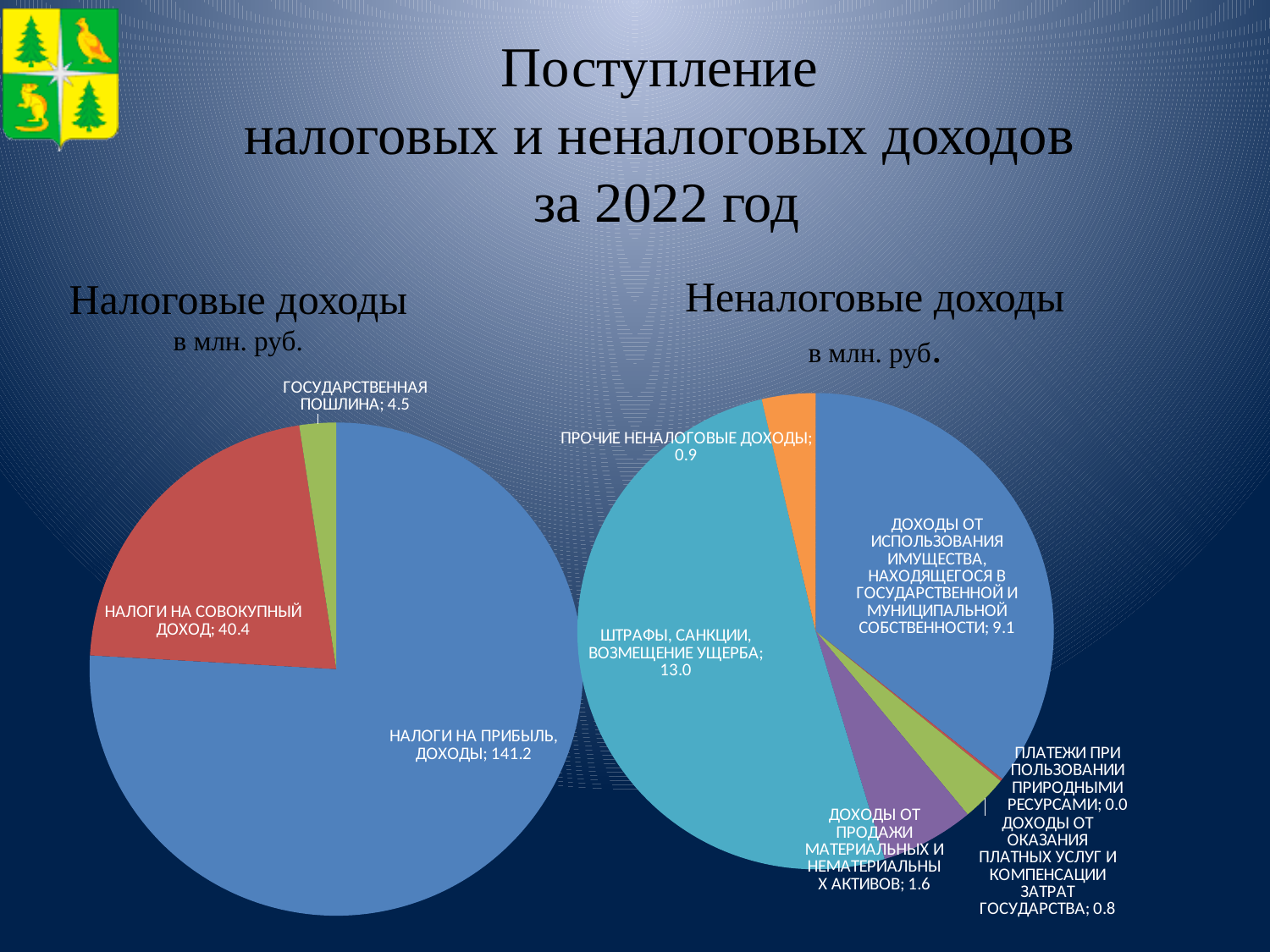
In the "Неналоговые доходы" pie chart, which is larger: ПРОЧИЕ НЕНАЛОГОВЫЕ ДОХОДЫ or ДОХОДЫ ОТ ОКАЗАНИЯ ПЛАТНЫХ УСЛУГ И КОМПЕНСАЦИИ ЗАТРАТ ГОСУДАРСТВА? ПРОЧИЕ НЕНАЛОГОВЫЕ ДОХОДЫ In the "Неналоговые доходы" pie chart, which category has the largest slice? ШТРАФЫ, САНКЦИИ, ВОЗМЕЩЕНИЕ УЩЕРБА In the "Налоговые доходы" pie chart, what is the value for НАЛОГИ НА ПРИБЫЛЬ, ДОХОДЫ? 141.2 In the "Налоговые доходы" pie chart, what is the value for ГОСУДАРСТВЕННАЯ ПОШЛИНА? 4.5 How many categories are shown in the "Неналоговые доходы" pie chart? 6 In the "Неналоговые доходы" pie chart, what is the value for ШТРАФЫ, САНКЦИИ, ВОЗМЕЩЕНИЕ УЩЕРБА? 13.0 In the "Налоговые доходы" pie chart, what is the difference between НАЛОГИ НА ПРИБЫЛЬ, ДОХОДЫ and НАЛОГИ НА СОВОКУПНЫЙ ДОХОД? 100.8 In the "Неналоговые доходы" pie chart, what is the value for ДОХОДЫ ОТ ПРОДАЖИ МАТЕРИАЛЬНЫХ И НЕМАТЕРИАЛЬНЫХ АКТИВОВ? 1.6 How many slices does the "Налоговые доходы" pie chart have? 3 In the "Неналоговые доходы" pie chart, what is the difference between ДОХОДЫ ОТ ИСПОЛЬЗОВАНИЯ ИМУЩЕСТВА and ШТРАФЫ, САНКЦИИ, ВОЗМЕЩЕНИЕ УЩЕРБА? 3.9 In the "Налоговые доходы" pie chart, which category has the smallest slice? ГОСУДАРСТВЕННАЯ ПОШЛИНА What type of chart is used for "Неналоговые доходы"? Pie chart